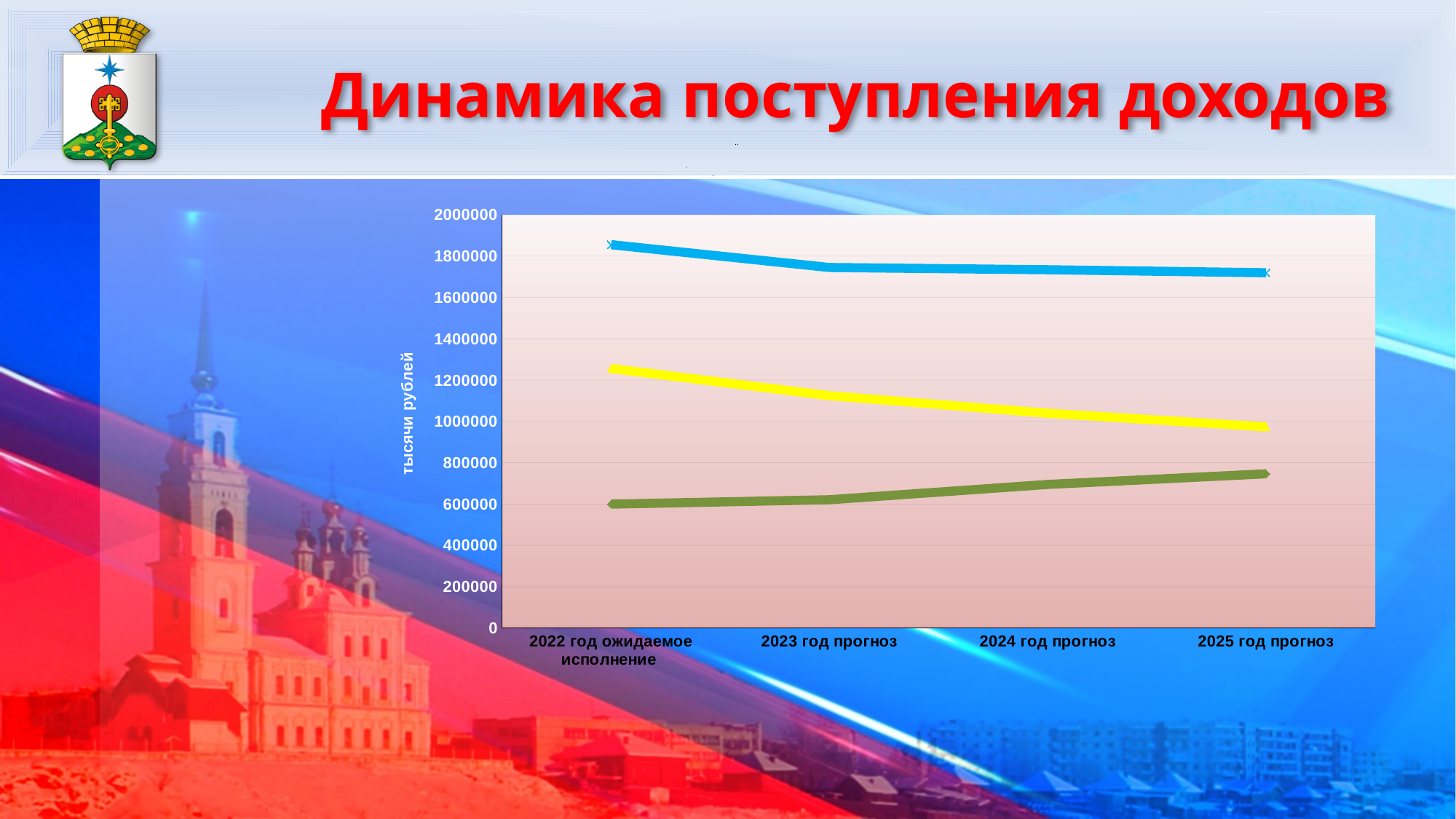
How many lines are plotted on the chart? 3 Which line has the lowest values across all years: blue, yellow or green? green Is the value of the blue line for 2022 год ожидаемое исполнение greater or less than 1800000? greater Does the green line rise or fall from 2022 год ожидаемое исполнение to 2025 год прогноз? rise What kind of chart is shown on the slide? line chart Is the value of the green line for 2025 год прогноз greater or less than 800000? less What is the title of the slide containing the chart? Динамика поступления доходов Does the blue line rise or fall from 2022 год ожидаемое исполнение to 2025 год прогноз? fall How many categories are shown on the x axis of the chart? 4 Which line has the highest values across all years: blue, yellow or green? blue Does the yellow line rise or fall from 2022 год ожидаемое исполнение to 2025 год прогноз? fall What is the label of the vertical axis of the chart? тысячи рублей